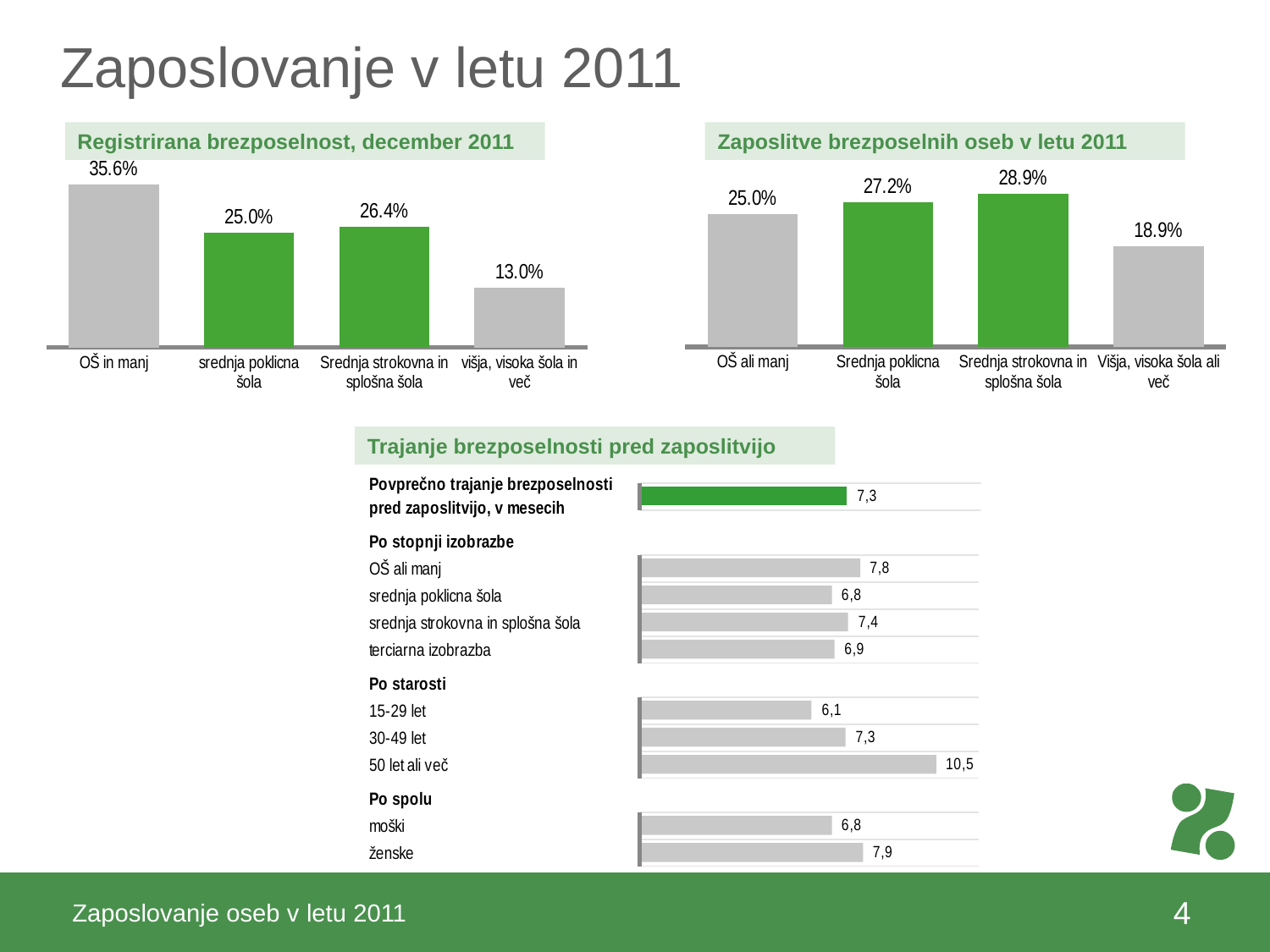
In the chart 'Zaposlitve brezposelnih oseb v letu 2011', which is larger: 'OŠ ali manj' or 'Višja, visoka šola ali več'? OŠ ali manj In the chart 'Trajanje brezposelnosti pred zaposlitvijo', what is the difference between 'ženske' and 'moški'? 1,1 In the chart 'Registrirana brezposelnost, december 2011', which category has the lowest value? višja, visoka šola in več In the chart 'Zaposlitve brezposelnih oseb v letu 2011', what is the value for 'Srednja poklicna šola'? 27.2% In the chart 'Trajanje brezposelnosti pred zaposlitvijo', what is the value for 'terciarna izobrazba'? 6,9 In the chart 'Registrirana brezposelnost, december 2011', what is the difference between 'OŠ in manj' and 'višja, visoka šola in več'? 22.6 percentage points In the chart 'Trajanje brezposelnosti pred zaposlitvijo', what is the average duration of unemployment before employment in months (Povprečno trajanje)? 7,3 In the chart 'Registrirana brezposelnost, december 2011', what is the value for 'OŠ in manj'? 35.6% In the chart 'Trajanje brezposelnosti pred zaposlitvijo', which age group has the longest duration? 50 let ali več In the chart 'Zaposlitve brezposelnih oseb v letu 2011', how many categories are shown? 4 In the chart 'Zaposlitve brezposelnih oseb v letu 2011', which category has the highest value? Srednja strokovna in splošna šola What type of chart is 'Registrirana brezposelnost, december 2011'? bar chart